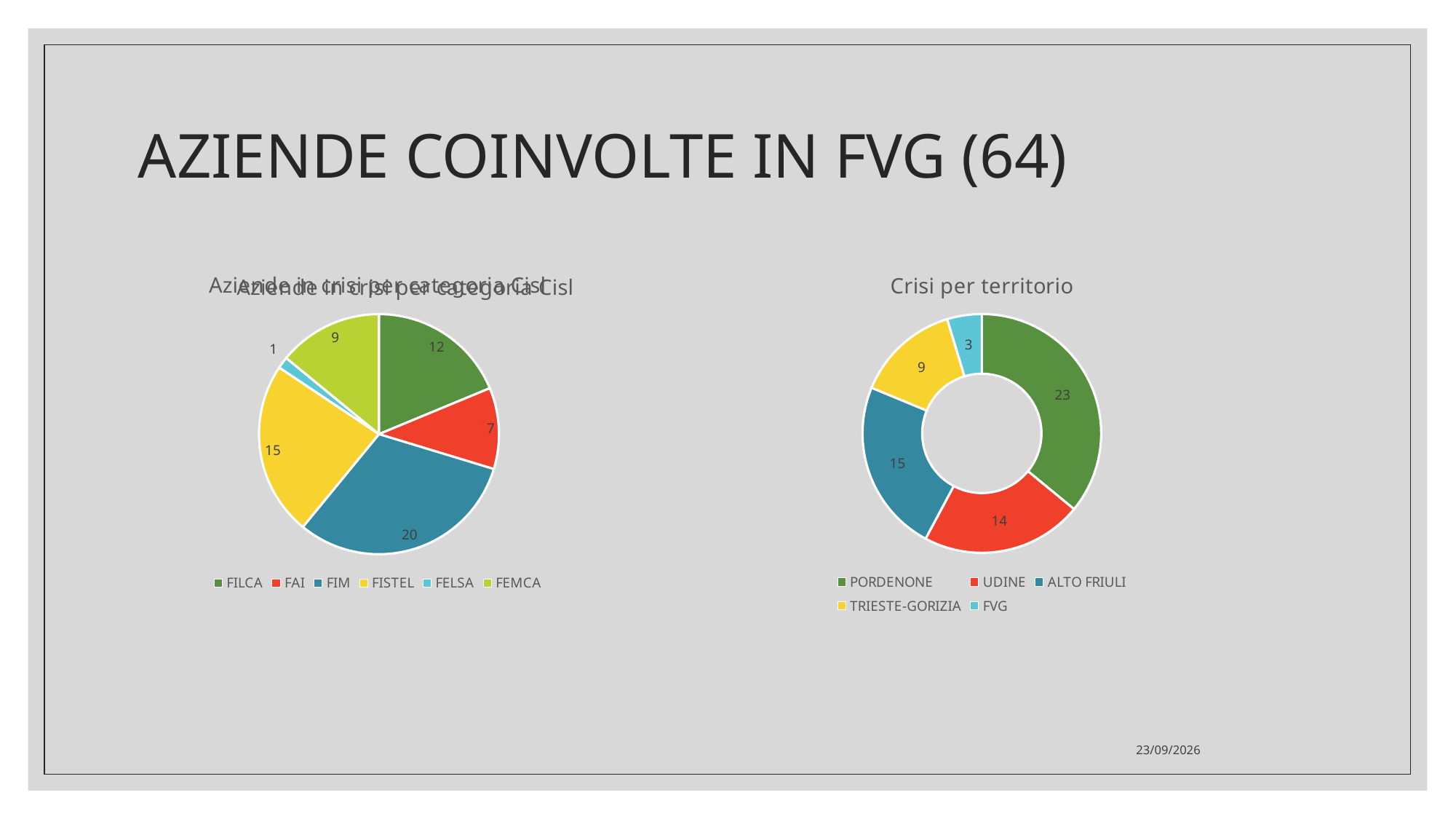
In the Crisi per territorio chart, what is the value for PORDENONE? 23 In the Crisi per territorio chart, what is the difference between PORDENONE and UDINE? 9 In the Crisi per territorio chart, what is the value for ALTO FRIULI? 15 In the left pie chart, which is larger, FISTEL or FILCA? FISTEL How many categories does the legend of the left pie chart list? 6 In the left pie chart, which category has the highest value? FIM In the left pie chart, what is the value for FELSA? 1 In the left pie chart, what is the value for FIM? 20 How many territories are shown in the Crisi per territorio chart? 5 In the left pie chart, what is the difference between FIM and FAI? 13 What kind of chart is the Crisi per territorio chart? Doughnut chart In the Crisi per territorio chart, which territory has the lowest value? FVG